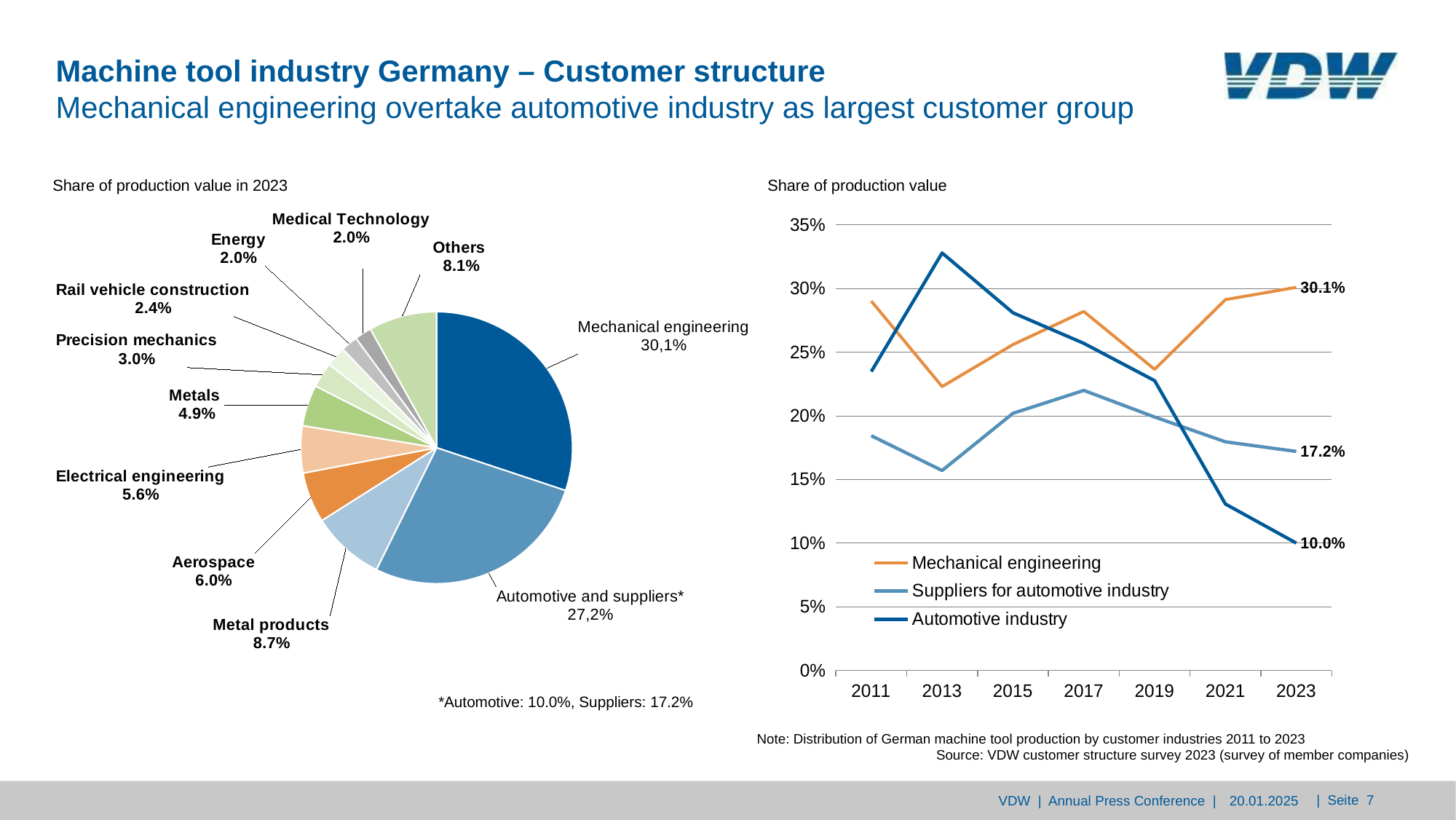
On the pie chart on the left, which category has the largest share? Mechanical engineering On the line chart on the right, what is the value for Automotive industry in 2023? 10.0% On the pie chart on the left, what is the share for Metal products? 8.7% On the pie chart on the left, what is the share for Mechanical engineering? 30,1% On the line chart on the right, how many series does the legend list? 3 What kind of chart is the chart on the right titled 'Share of production value'? Line chart On the line chart on the right, does the Automotive industry line rise or fall between 2013 and 2023? Fall On the line chart on the right, what is the value for Suppliers for automotive industry in 2023? 17.2% On the pie chart on the left, how many slices are shown? 11 On the pie chart on the left, which is larger: the share for Metals or the share for Precision mechanics? Metals On the line chart on the right, is the value for Automotive industry in 2013 greater or less than 30%? greater On the pie chart on the left, what is the difference between the shares of Aerospace and Electrical engineering? 0.4%